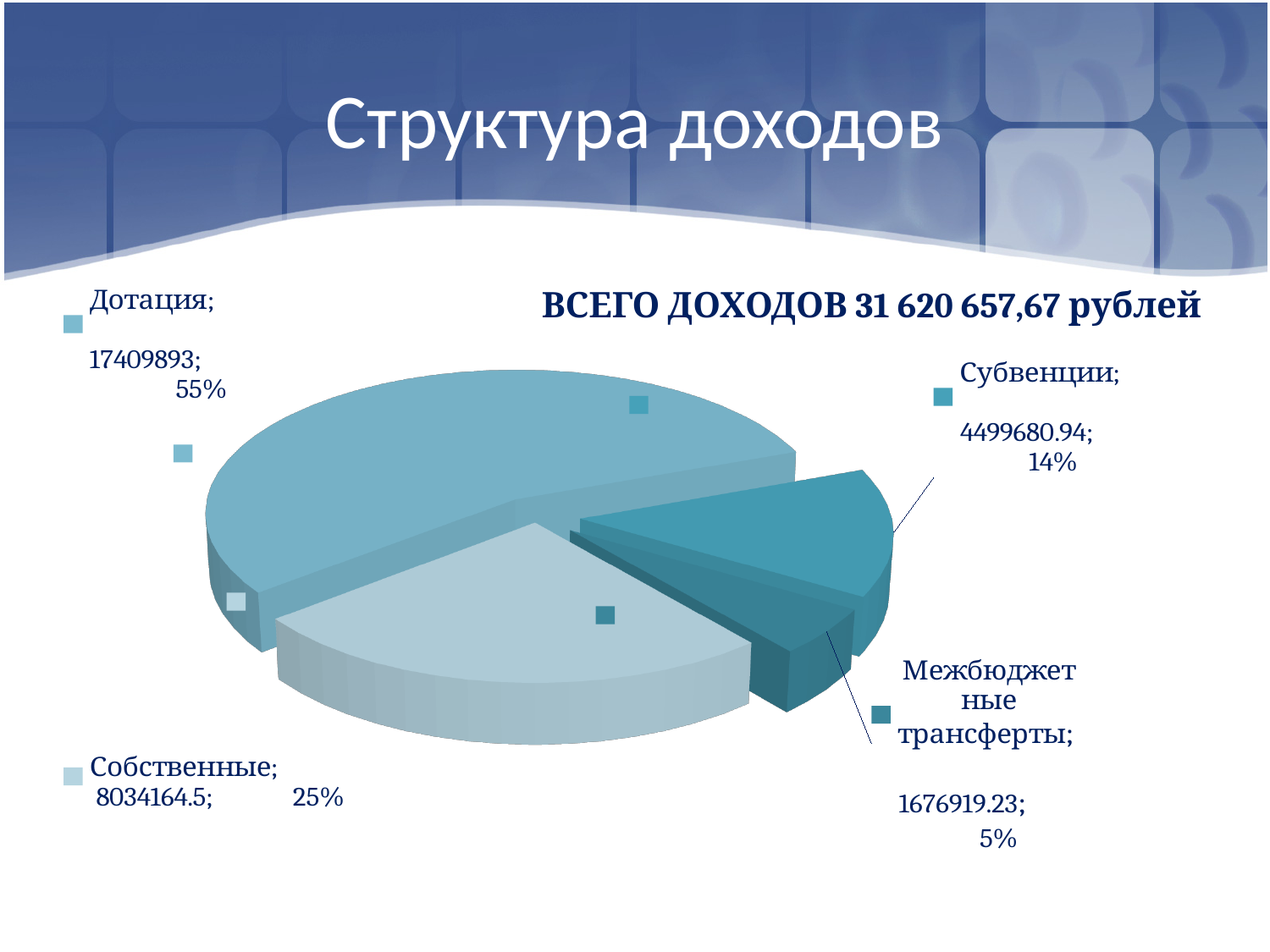
How many slices does the pie chart have? 4 What is the value for Субвенции? 4499680.94 What is the total income stated on the slide? 31 620 657,67 рублей What is the value for Дотация? 17409893 What kind of chart is shown on the slide? pie chart What percentage share does Межбюджетные трансферты have? 5% Which category has the smallest share of the pie? Межбюджетные трансферты Which category has the largest share of the pie? Дотация What percentage share does Собственные have? 25% What is the title of the slide? Структура доходов What is the difference in percentage points between the shares of Дотация and Собственные? 30% Which is larger, Субвенции or Собственные? Собственные